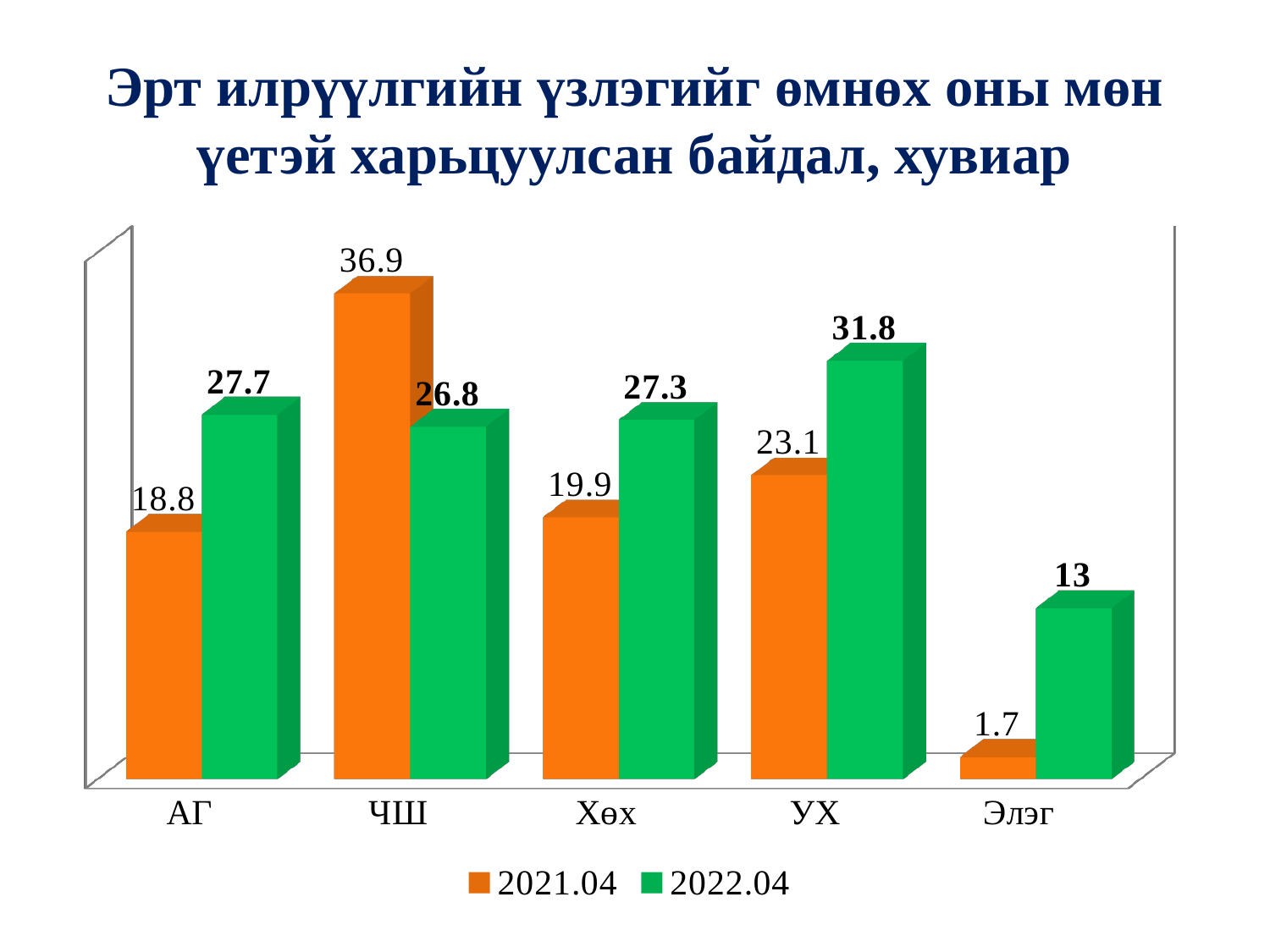
What is the value for УХ in the 2022.04 series? 31.8 What kind of chart is shown on the slide? bar chart What is the difference between the 2022.04 and 2021.04 values for Элэг? 11.3 How many categories are shown on the x axis? 5 Which is larger for АГ: the 2021.04 value or the 2022.04 value? 2022.04 How many series does the legend list? 2 Which colour represents the 2022.04 series? green Which category has the highest value in the 2022.04 series? УХ What is the value for Элэг in the 2021.04 series? 1.7 What is the value for ЧШ in the 2021.04 series? 36.9 What is the difference between the 2021.04 and 2022.04 values for ЧШ? 10.1 Which category has the lowest value in the 2021.04 series? Элэг